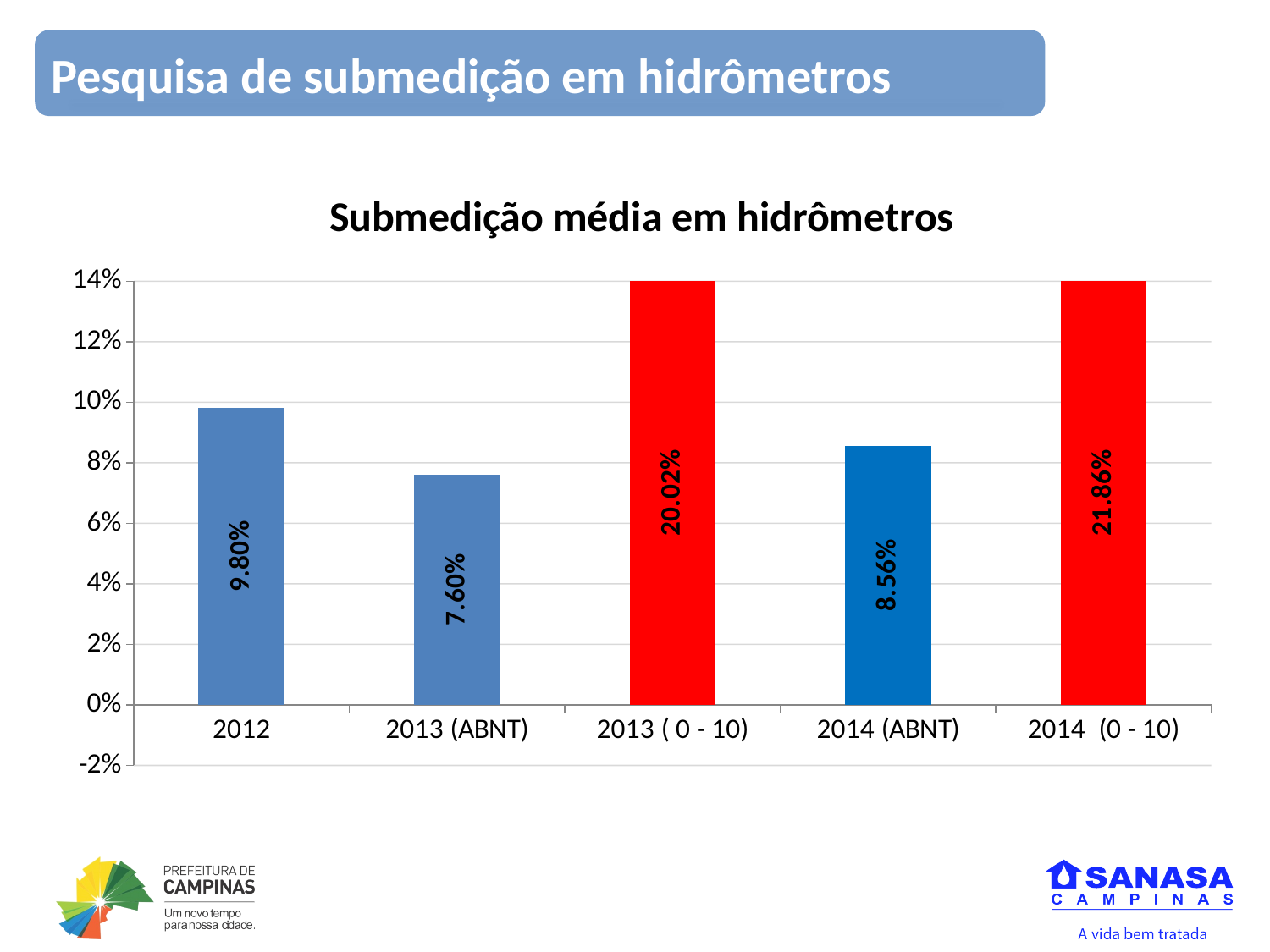
What is the value for 2013 (ABNT)? 7.60% Which category has the highest value? 2014 (0 - 10) What is the value for 2013 ( 0 - 10)? 20.02% What is the value for 2012? 9.80% What is the difference between the values for 2014 (0 - 10) and 2013 ( 0 - 10)? 1.84% Which category has the lowest value? 2013 (ABNT) How many categories are shown on the x axis? 5 What is the title of the chart? Submedição média em hidrômetros What is the value for 2014 (0 - 10)? 21.86% What kind of chart is shown on the slide? Bar chart What is the value for 2014 (ABNT)? 8.56% Which is larger, the value for 2012 or the value for 2014 (ABNT)? 2012